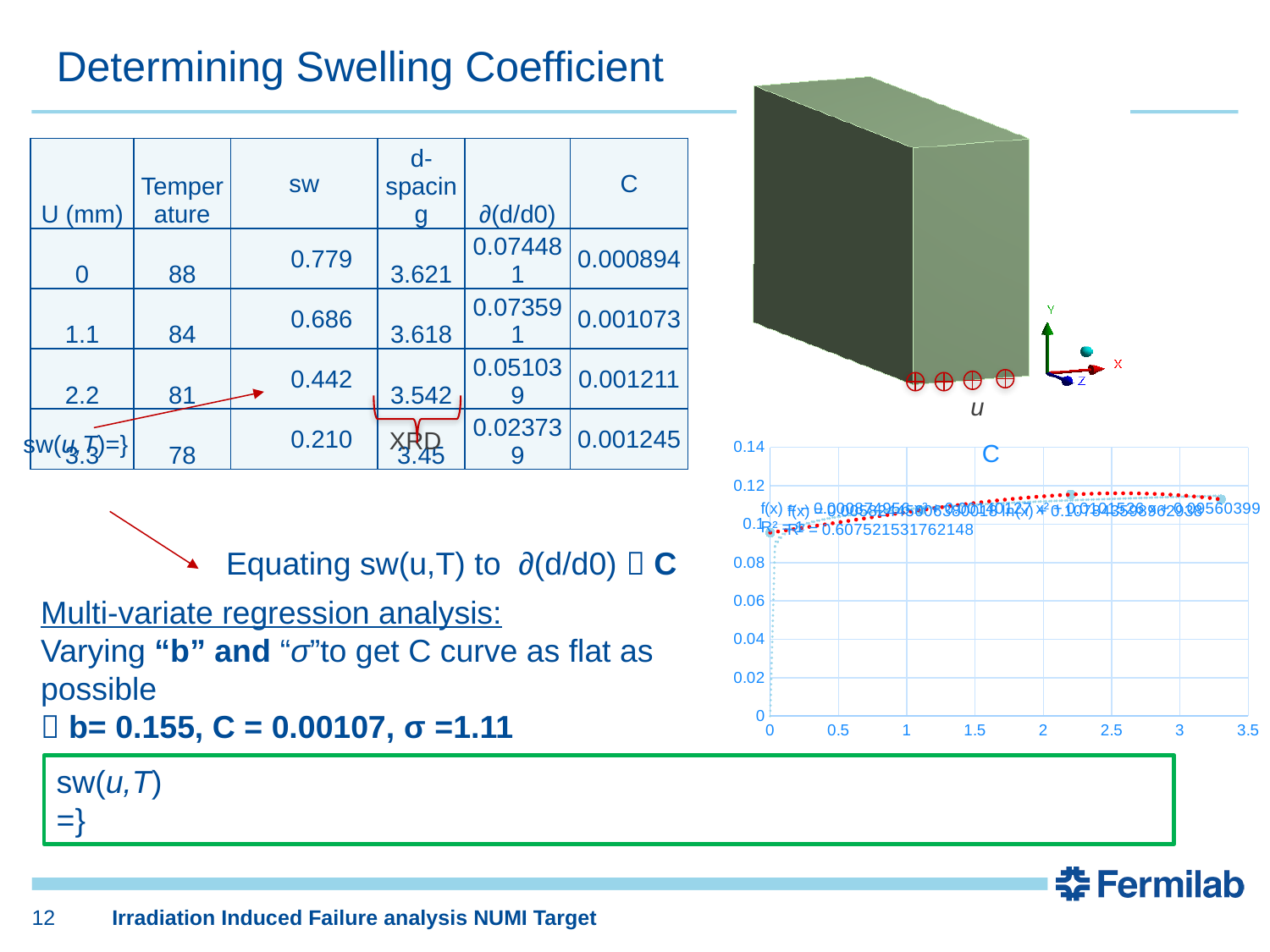
What is the highest tick value shown on the y axis of the chart? 0.14 How many data points are plotted in the chart? 4 What kind of chart is shown on the slide? scatter chart Is the plotted value at u = 3.3 greater or less than 0.14? less What is the title of the chart? C Do the plotted values rise or fall as u increases along the x axis? rise Is the plotted value at u = 2.2 greater or less than 0.1? greater Is the plotted value at u = 0 greater or less than 0.12? less Which plotted point has the lowest value? u = 0 Which is larger, the plotted value at u = 0 or at u = 3.3? u = 3.3